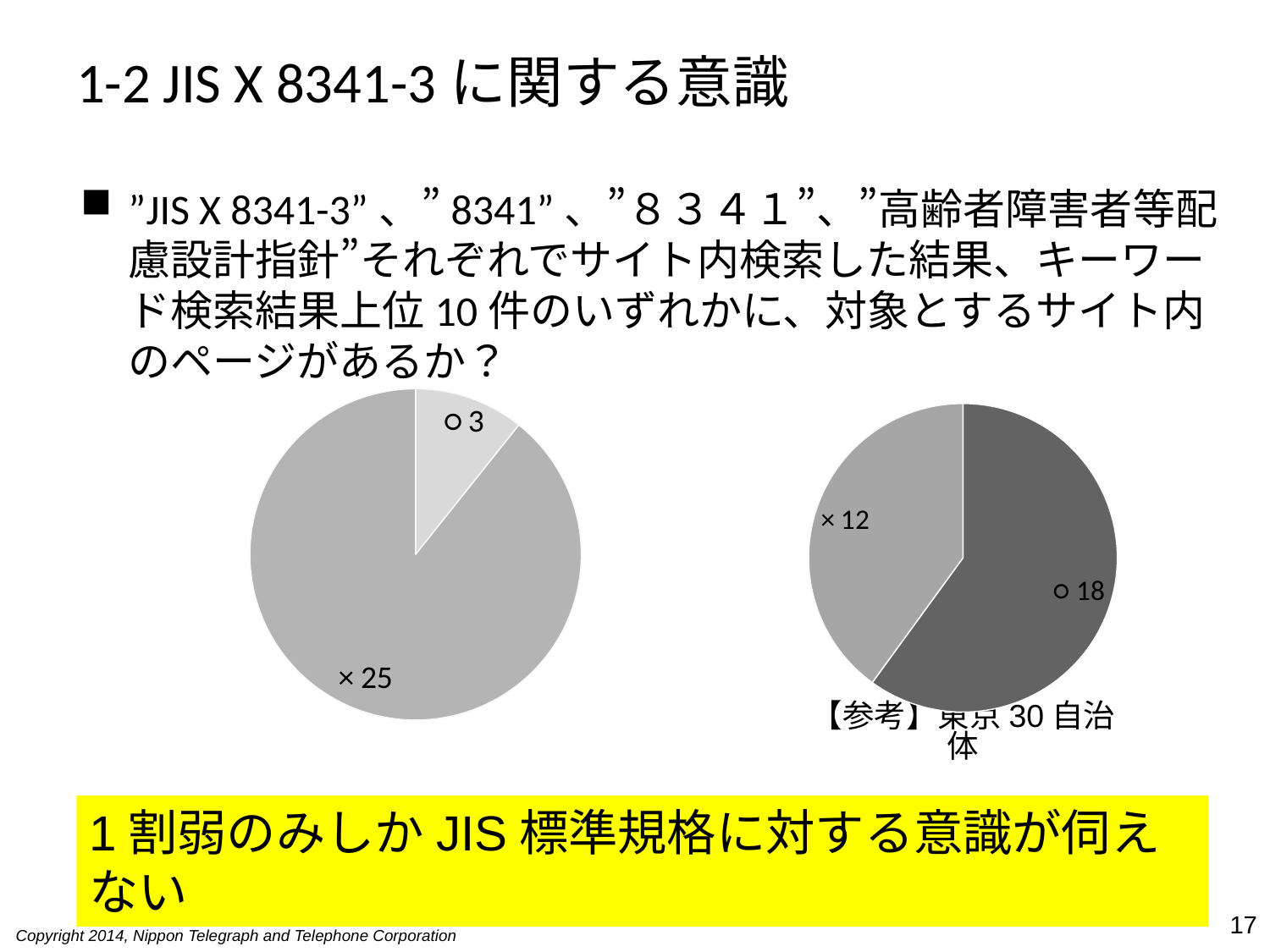
In the left pie chart, what is the value for the ○ slice? 3 In the left pie chart, what is the difference between the × value and the ○ value? 22 What caption is shown below the right pie chart? 【参考】東京30自治体 In the right pie chart (【参考】東京30自治体), what is the value for the × slice? 12 What kind of chart is the chart on the left of the slide? pie chart In the right pie chart (【参考】東京30自治体), what is the total of the two slices? 30 In the right pie chart (【参考】東京30自治体), what is the value for the ○ slice? 18 In the left pie chart, which slice is the largest? × In the right pie chart (【参考】東京30自治体), which slice is larger, ○ or ×? ○ In the right pie chart (【参考】東京30自治体), what share of the total does the ○ slice represent? 60% In the left pie chart, what is the value for the × slice? 25 How many slices does the left pie chart have? 2